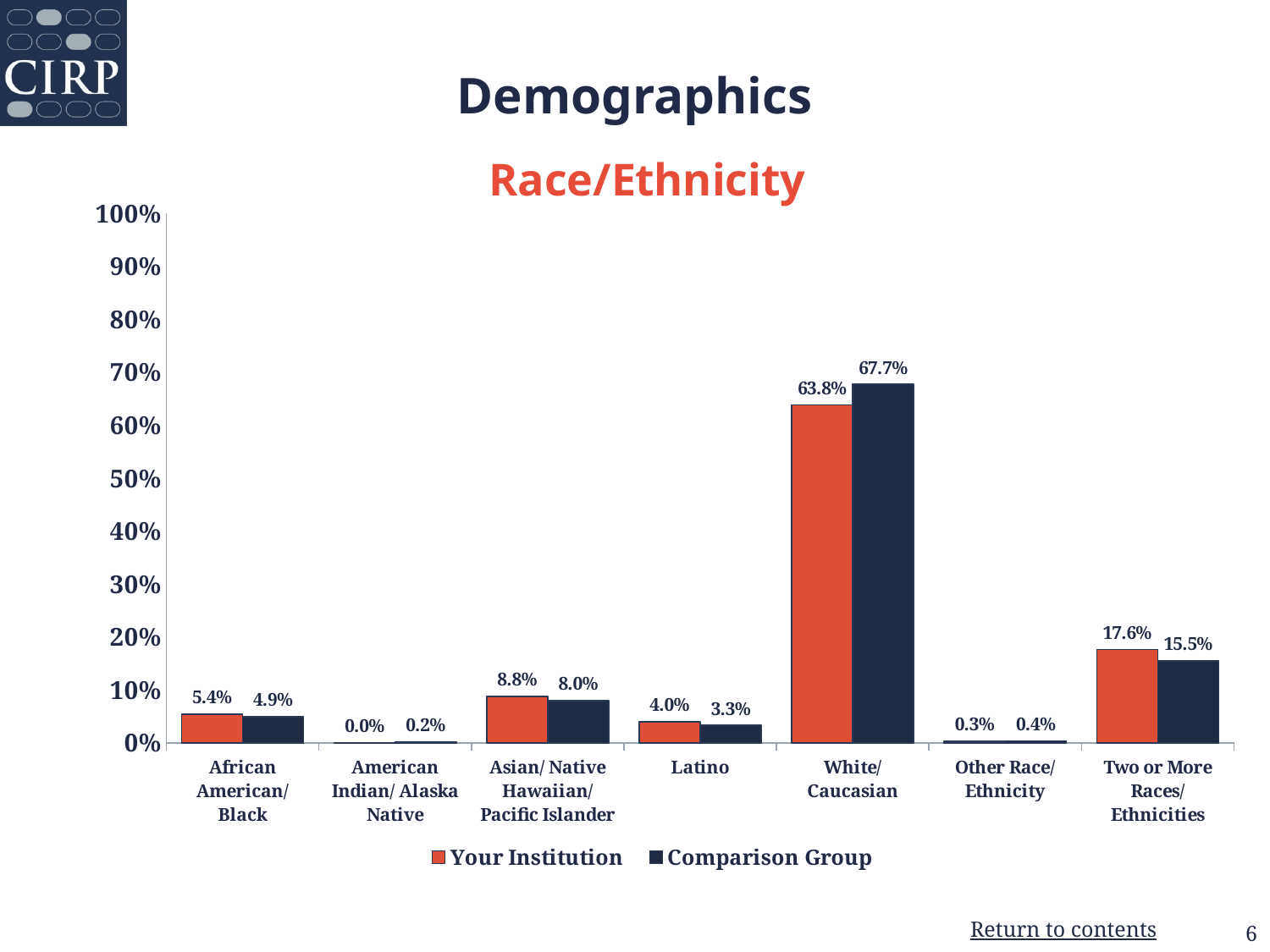
What is the value for Your Institution in the Latino category? 4.0% Which is larger for Asian/Native Hawaiian/Pacific Islander: Your Institution or the Comparison Group? Your Institution Which category has the highest value for the Comparison Group? White/Caucasian Which category has the lowest value for Your Institution? American Indian/Alaska Native Is the Comparison Group value for White/Caucasian greater or less than 60%? greater What is the difference between Your Institution and the Comparison Group values for Two or More Races/Ethnicities? 2.1% What is the value for Your Institution in the White/Caucasian category? 63.8% What is the difference between the Comparison Group and Your Institution values for White/Caucasian? 3.9% How many race/ethnicity categories are shown on the x axis? 7 How many series does the legend list? 2 What is the value for the Comparison Group in the Two or More Races/Ethnicities category? 15.5% What kind of chart is shown on the slide? Bar chart